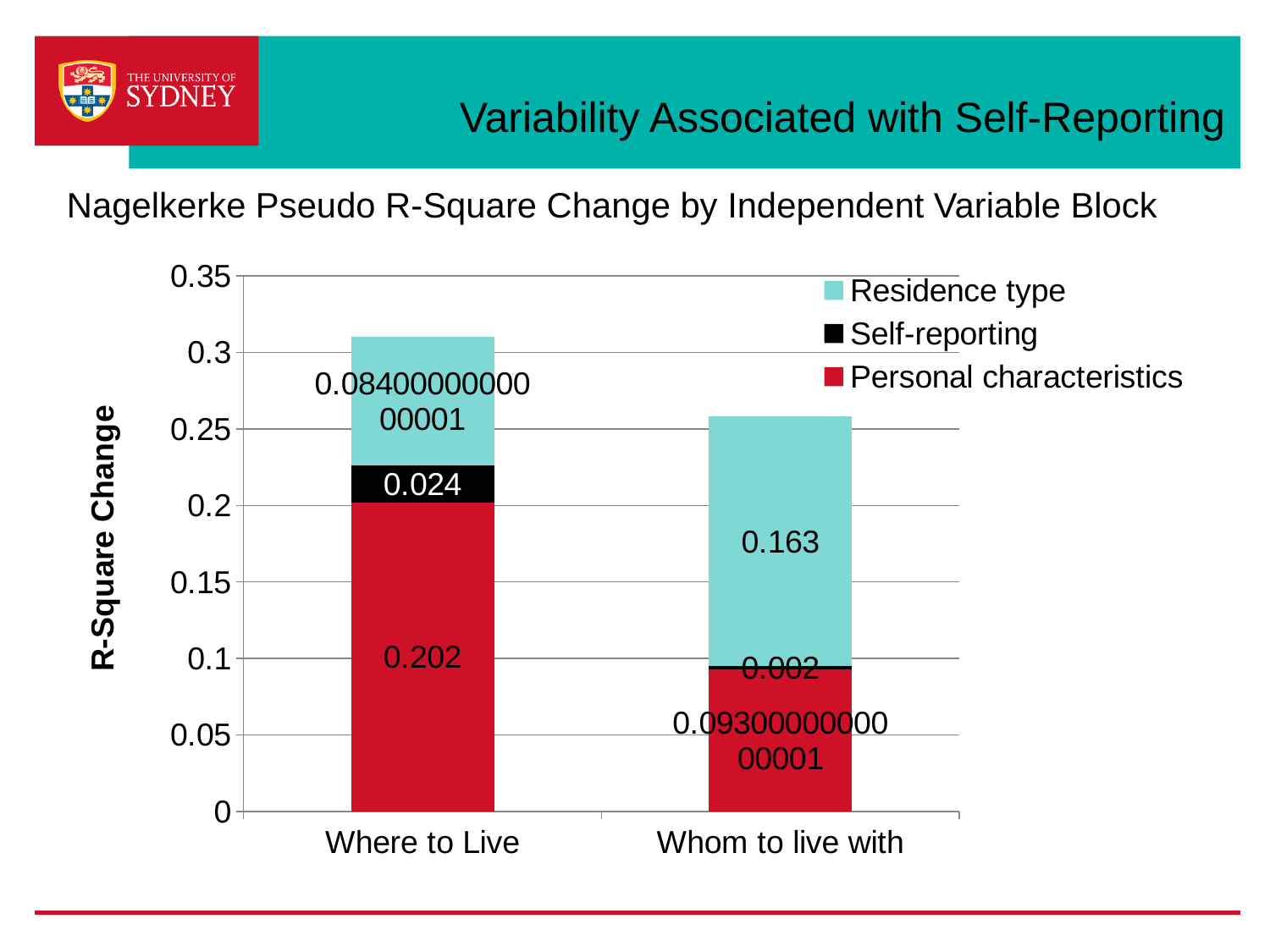
For Where to Live, how much larger is the Personal characteristics value than the Self-reporting value? 0.178 Which category has the larger Personal characteristics value, Where to Live or Whom to live with? Where to Live What is the value of the Personal characteristics segment for Where to Live? 0.202 Is the total height of the Whom to live with bar greater or less than 0.3? less How many series does the legend list? 3 What is the value of the Self-reporting segment for Where to Live? 0.024 What is the value of the Self-reporting segment for Whom to live with? 0.002 Which series has the largest segment in the Whom to live with bar? Residence type Which category has the taller stacked bar overall? Where to Live What is the difference between the Self-reporting values for Where to Live and Whom to live with? 0.022 What is the value of the Residence type segment for Whom to live with? 0.163 How many categories are shown on the x axis? 2